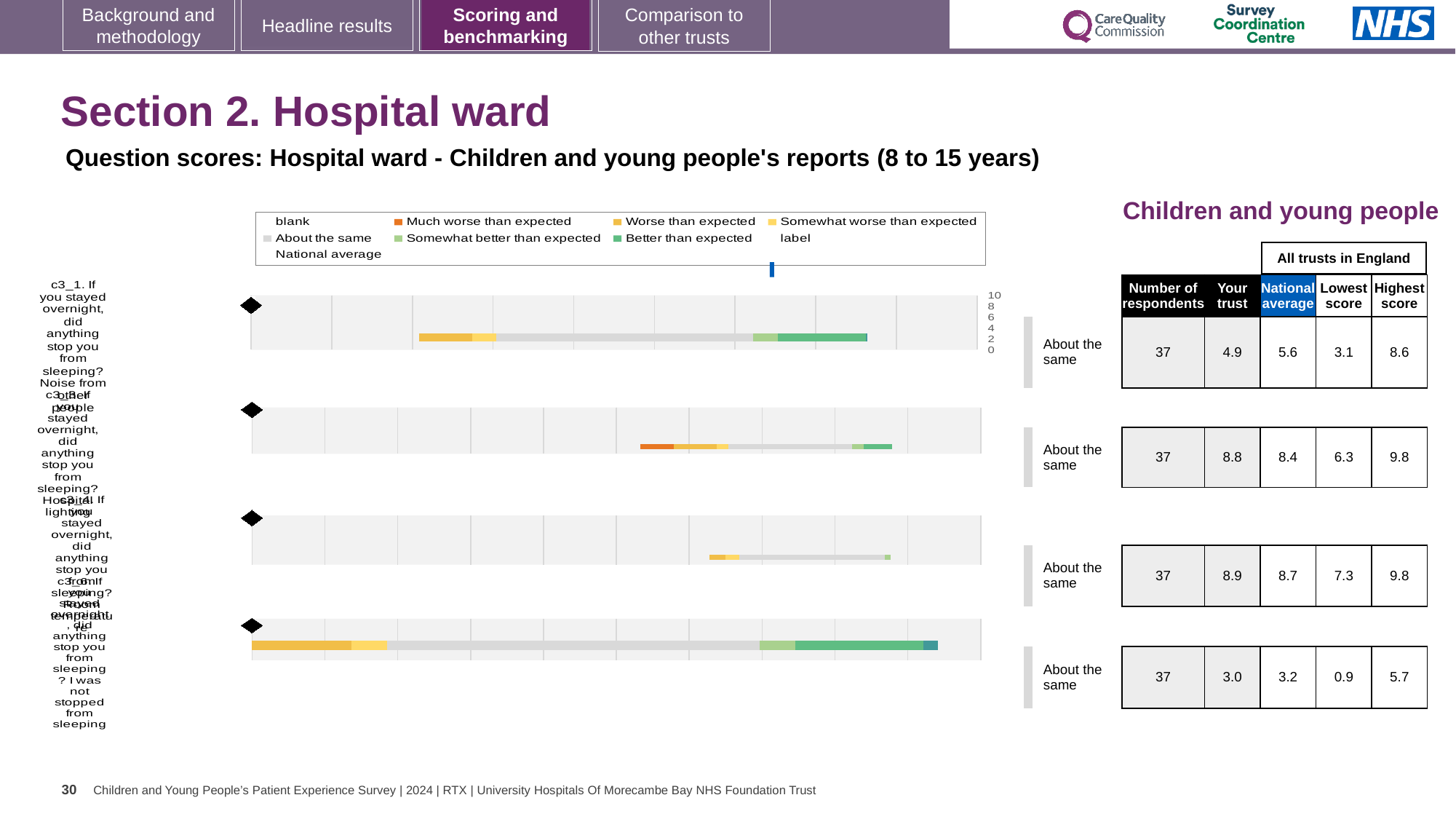
For the top chart (c3_1, noise from other people), what is the 'Your trust' score shown in the table? 4.9 For the top chart (c3_1, noise from other people), what is the difference between the highest score (8.6) and the lowest score (3.1)? 5.5 For the bottom chart, what is the lowest score among all trusts in England? 0.9 What colour does the legend use for 'Better than expected'? green Which of the four charts has the highest 'Your trust' score? the third chart from the top (8.9) How many separate bar charts are shown on the slide? 4 What kind of chart is used to show the question scores on this slide? bar chart For the second chart from the top, what is the 'Your trust' score? 8.8 How many respondents are listed for the third chart from the top? 37 For the top chart (c3_1, noise from other people), what is the national average score? 5.6 For the second chart from the top, which is larger: the 'Your trust' score or the national average? Your trust What colour does the legend use for 'Much worse than expected'? orange